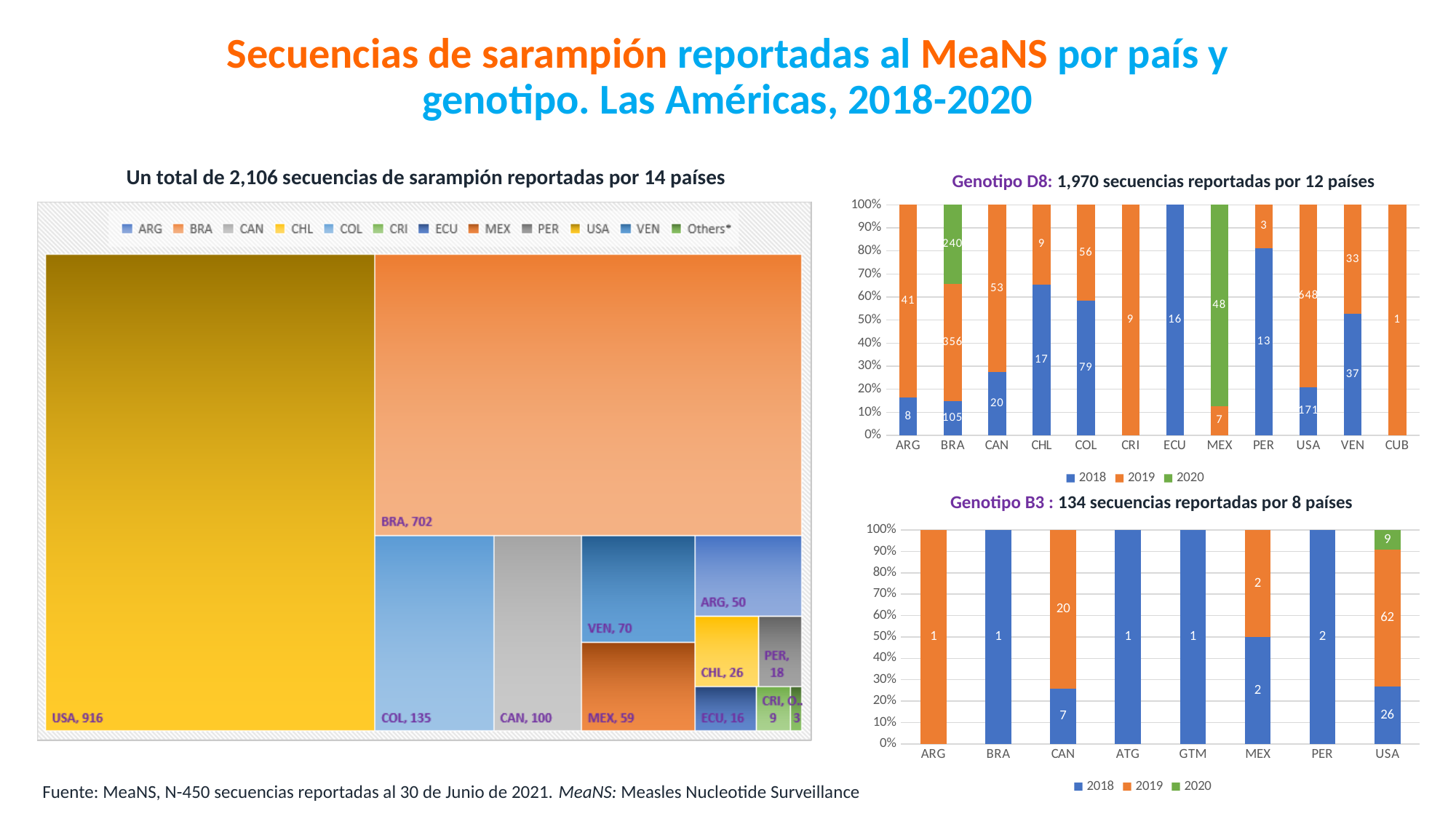
In the Genotipo B3 chart, what is the 2019 value for CAN? 20 In the treemap on the left, which country has the largest number of sequences? USA In the Genotipo D8 chart, what is the 2020 value for BRA? 240 In the Genotipo D8 chart, how many series does the legend list? 3 In the Genotipo D8 chart, what is the total of the BRA bar across all years? 701 In the treemap on the left, how many sequences are shown for USA? 916 In the treemap on the left, how many sequences are shown for BRA? 702 In the treemap on the left, what is the difference between the USA and BRA values? 214 In the Genotipo B3 chart, what is the total of the USA bar across all years? 97 In the Genotipo D8 chart, which is larger, the 2018 value for COL or the 2018 value for CAN? COL In the Genotipo D8 chart, what is the 2019 value for USA? 648 In the Genotipo D8 chart, how many countries are shown on the x axis? 12